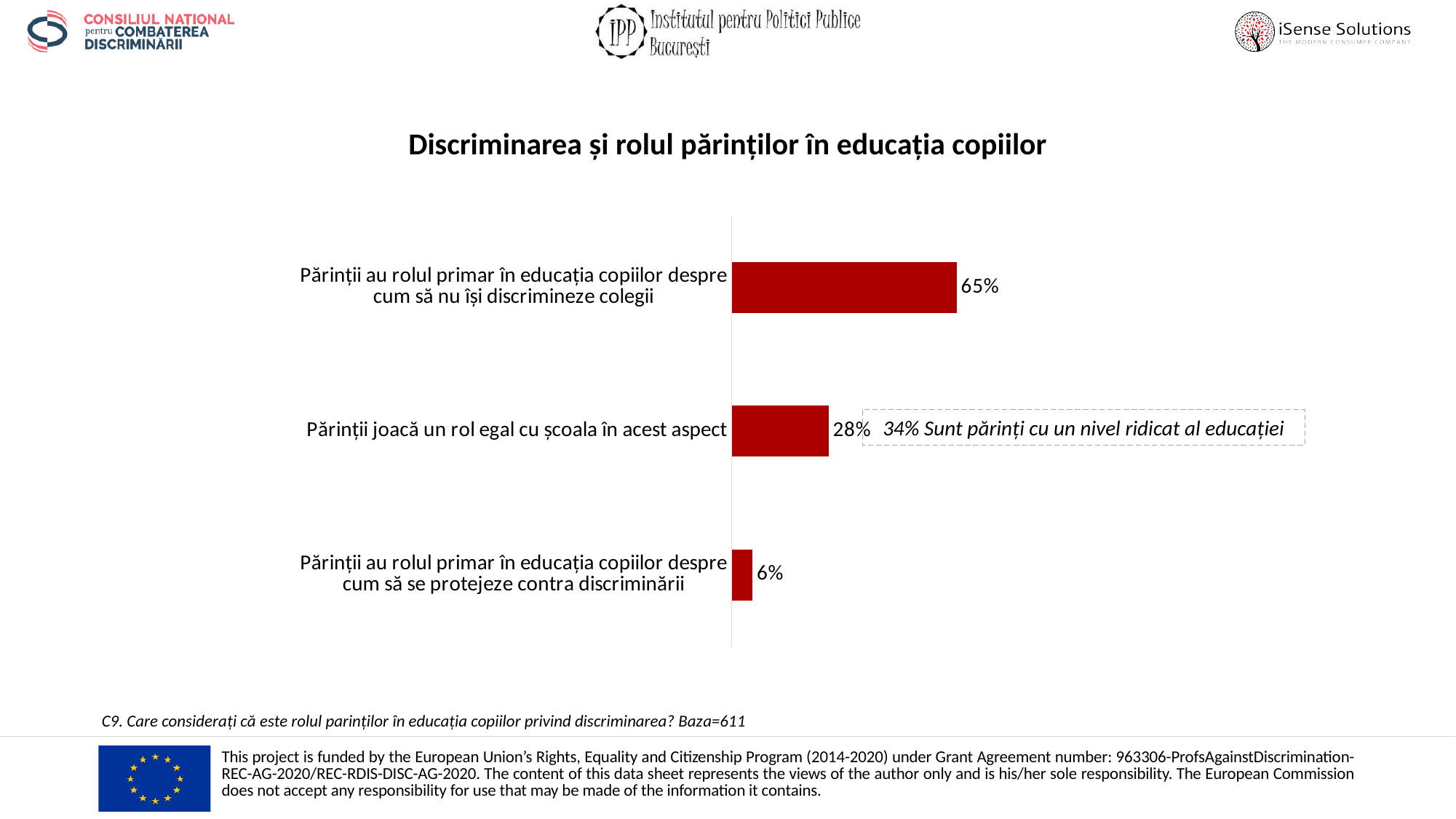
What is the difference between the value for "Părinții joacă un rol egal cu școala în acest aspect" and the value for "Părinții au rolul primar în educația copiilor despre cum să se protejeze contra discriminării"? 22 percentage points What percentage of respondents say parents have the primary role in educating children about how not to discriminate against their colleagues ("Părinții au rolul primar în educația copiilor despre cum să nu își discrimineze colegii")? 65% Which is larger: the value for "Părinții joacă un rol egal cu școala în acest aspect" or the value for "Părinții au rolul primar în educația copiilor despre cum să se protejeze contra discriminării"? Părinții joacă un rol egal cu școala în acest aspect What is the value for "Părinții joacă un rol egal cu școala în acest aspect"? 28% Which category has the highest value? Părinții au rolul primar în educația copiilor despre cum să nu își discrimineze colegii What is the value for "Părinții au rolul primar în educația copiilor despre cum să se protejeze contra discriminării"? 6% According to the annotation next to the "Părinții joacă un rol egal cu școala în acest aspect" bar, what percentage of parents with a high level of education gave this answer? 34% How many categories are shown in the chart? 3 What is the difference between the highest value (65%) and the value for "Părinții joacă un rol egal cu școala în acest aspect" (28%)? 37 percentage points What type of chart is shown on the slide? Bar chart Which category has the lowest value? Părinții au rolul primar în educația copiilor despre cum să se protejeze contra discriminării What is the title of the chart? Discriminarea și rolul părinților în educația copiilor